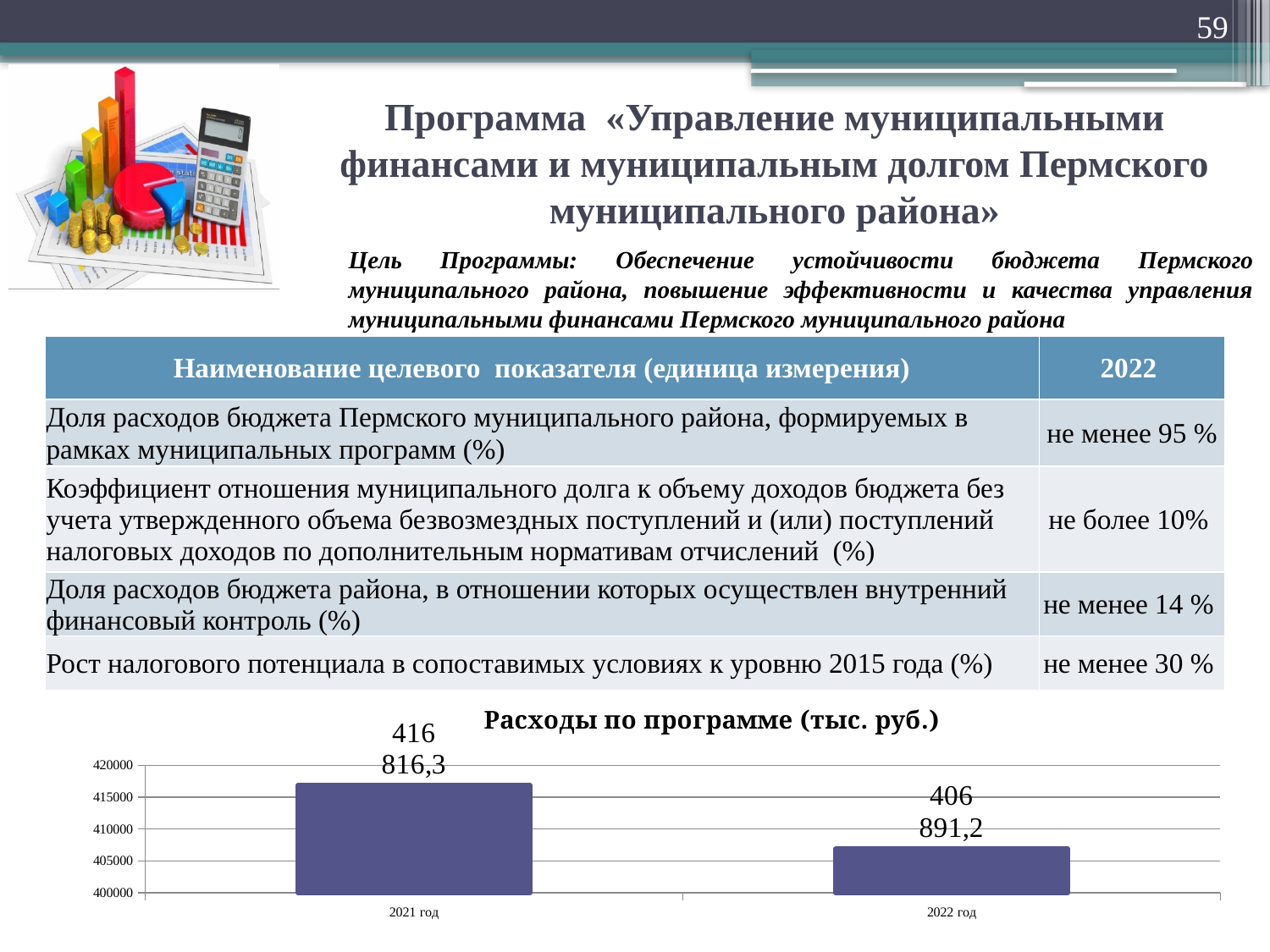
Which year has the highest value in the chart? 2021 год What is the difference between the values for 2021 год and 2022 год? 9 925,1 Do the values rise or fall from 2021 год to 2022 год? fall Which is larger, the value for 2021 год or the value for 2022 год? 2021 год Which year has the lowest value in the chart? 2022 год What is the title of the chart on the slide? Расходы по программе (тыс. руб.) Is the value for 2021 год greater or less than 415000? greater What type of chart is shown on the slide? bar chart How many categories are shown on the x axis of the chart? 2 What is the value for 2022 год in the chart? 406 891,2 What is the value for 2021 год in the chart? 416 816,3 Is the value for 2022 год greater or less than 410000? less